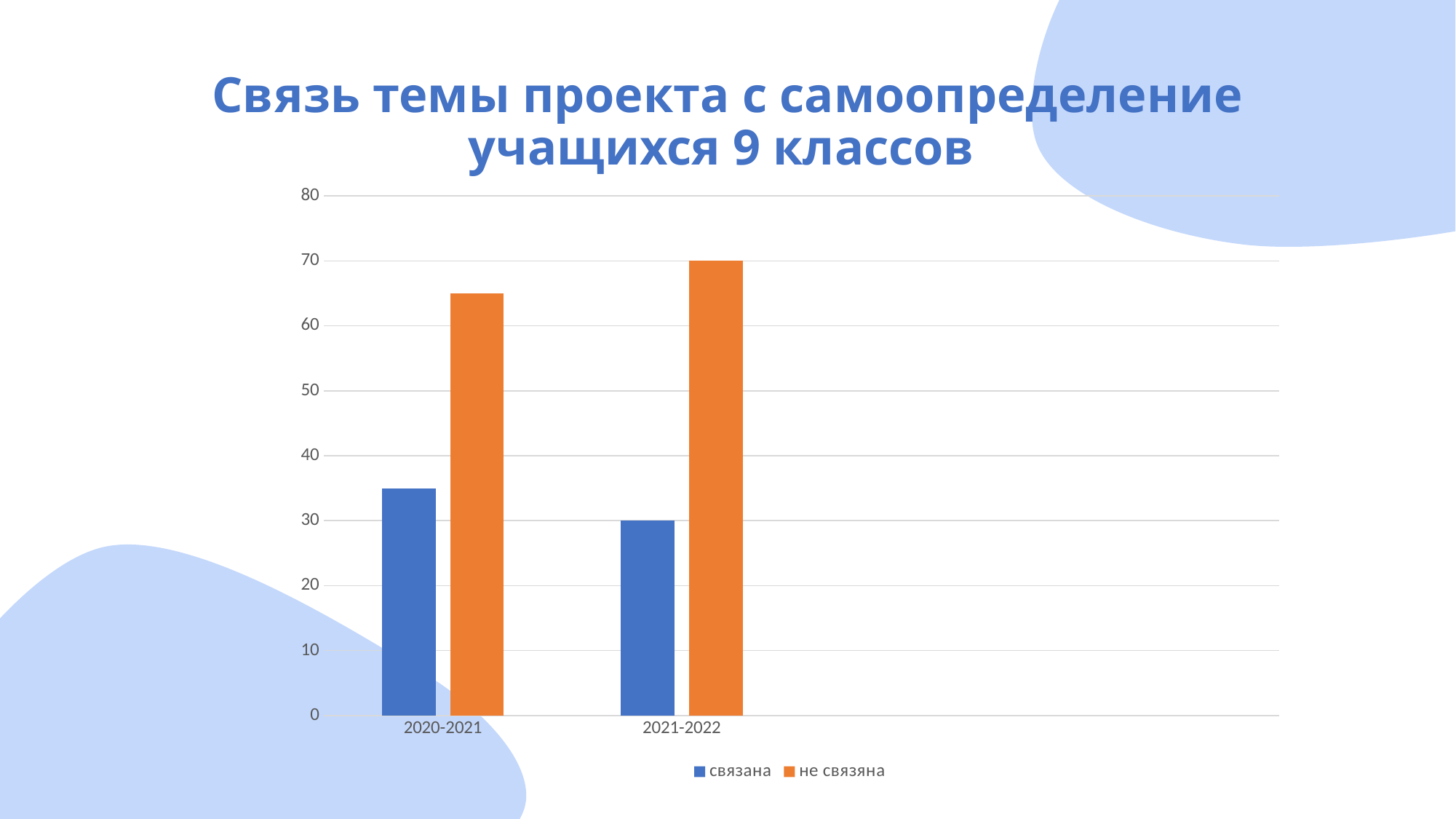
How many categories are shown on the x axis? 2 Does the value for "связана" rise or fall from 2020-2021 to 2021-2022? fall What is the value for "не связяна" in 2021-2022? 70 Which bar is the shortest on the chart? связана, 2021-2022 What kind of chart is shown on the slide? bar chart Is the value for "связана" in 2020-2021 greater or less than 40? less Is the value for "не связяна" in 2020-2021 greater or less than 60? greater What is the difference between "не связяна" and "связана" in 2021-2022? 40 How many series does the legend list? 2 Which bar is the tallest on the chart? не связяна, 2021-2022 What is the value for "связана" in 2021-2022? 30 Which series has the higher value in 2020-2021, "связана" or "не связяна"? не связяна